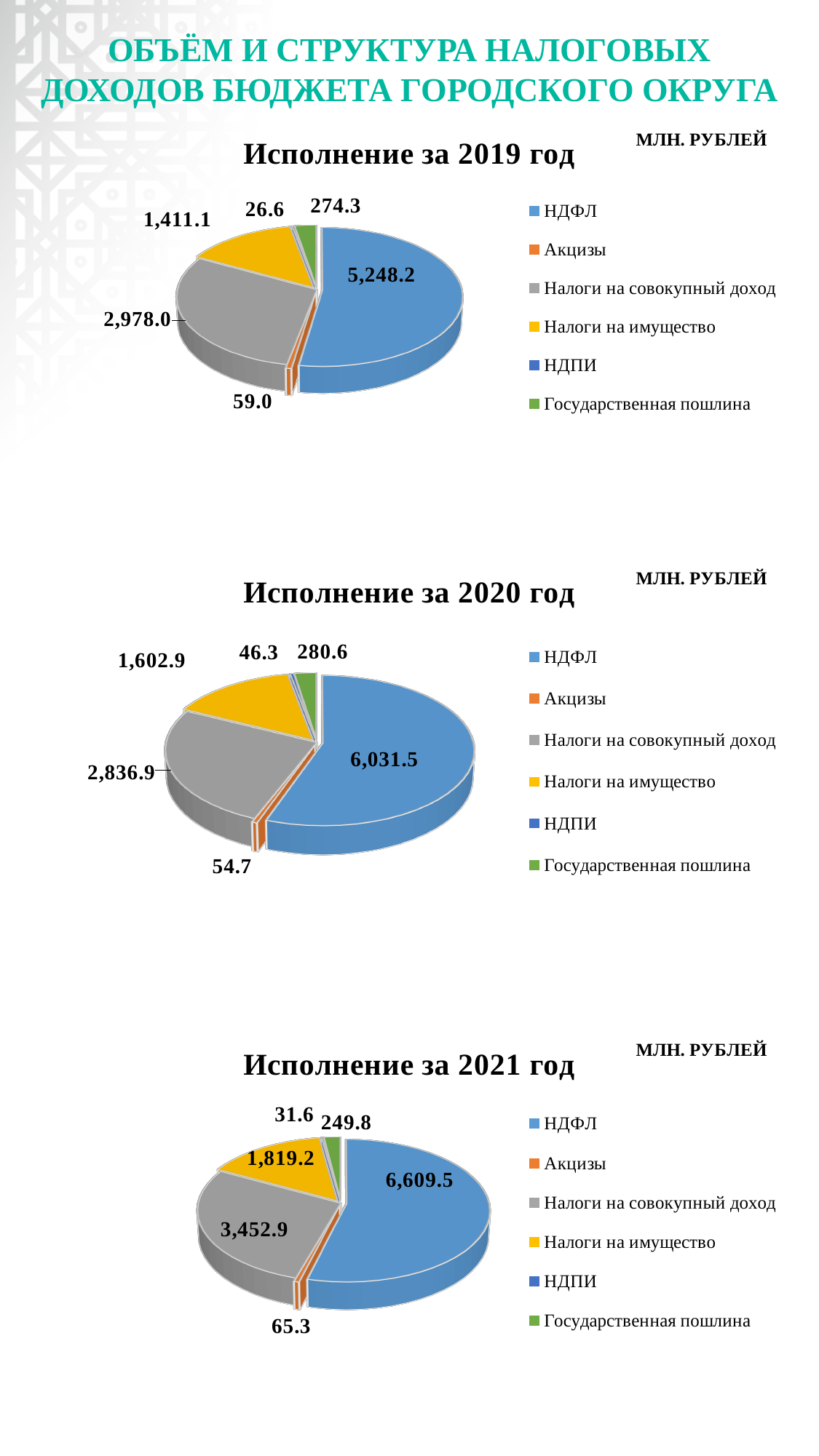
In the 'Исполнение за 2020 год' chart, which is larger: Государственная пошлина or Акцизы? Государственная пошлина In the 'Исполнение за 2019 год' chart, what is the value for НДПИ? 26.6 What type of chart is 'Исполнение за 2021 год'? Pie chart How many categories does the 'Исполнение за 2019 год' chart show? 6 In the 'Исполнение за 2021 год' chart, which category has the largest value? НДФЛ In the 'Исполнение за 2019 год' chart, what is the difference between НДФЛ and Налоги на совокупный доход? 2,270.2 What unit is stated next to the chart titles on the slide? МЛН. РУБЛЕЙ In the 'Исполнение за 2020 год' chart, which category has the smallest value? НДПИ In the 'Исполнение за 2019 год' chart, what is the value for НДФЛ? 5,248.2 In the 'Исполнение за 2020 год' chart, what is the value for Налоги на имущество? 1,602.9 In the 'Исполнение за 2021 год' chart, what is the value for Налоги на совокупный доход? 3,452.9 In the 'Исполнение за 2021 год' chart, what is the value for Акцизы? 65.3